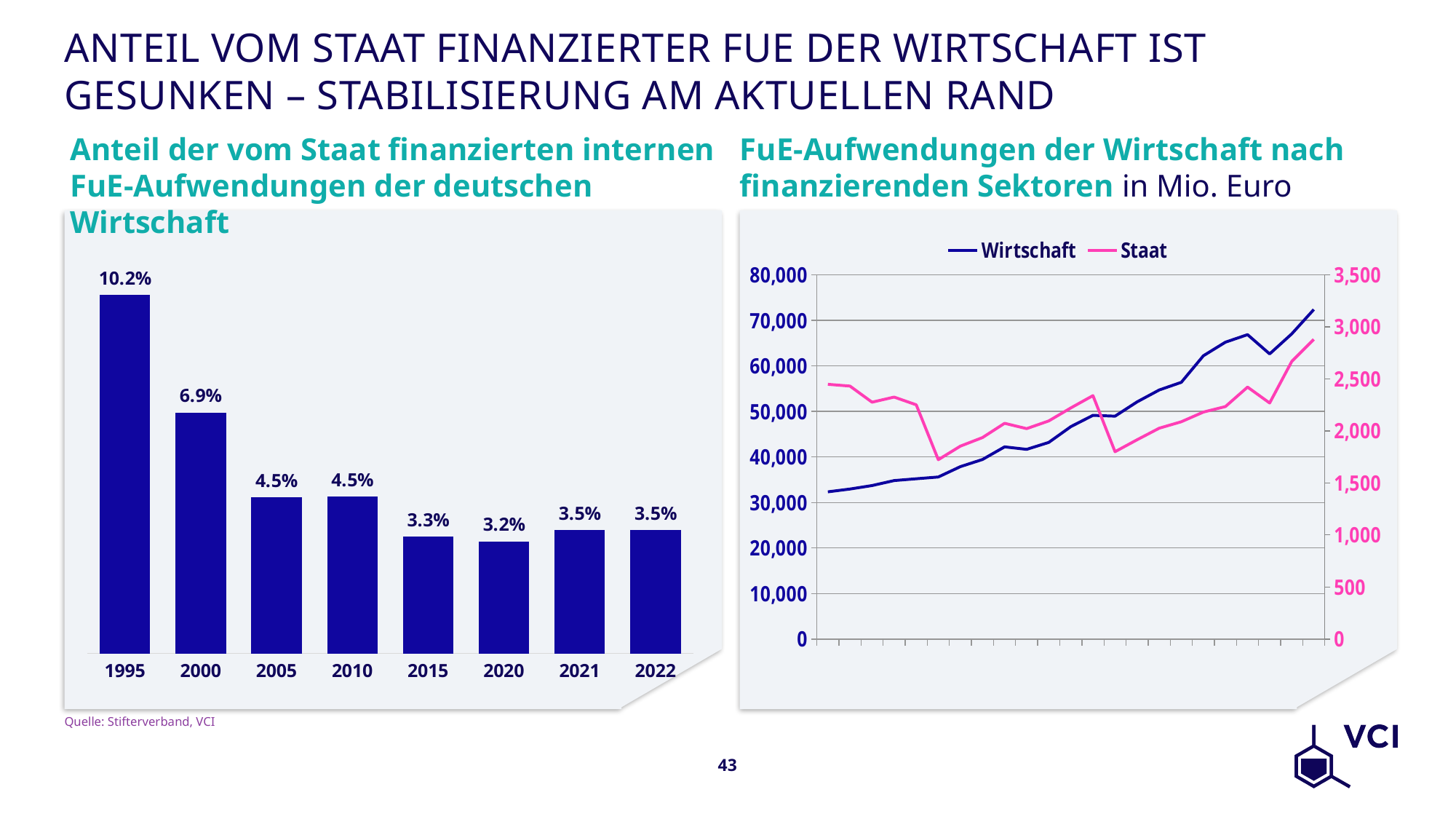
How many series does the legend of the right chart list? 2 In the left bar chart, what is the difference between the values for 1995 and 2000? 3.3% In the left bar chart, which is larger, the value for 2015 or the value for 2021? 2021 In the right chart, does the Wirtschaft line generally rise or fall from left to right? rise In the left bar chart, which year has the highest value? 1995 How many bars are shown in the left bar chart? 8 In the left bar chart, which year has the lowest value? 2020 What kind of chart is the right chart? line chart In the left bar chart, what is the value for 1995? 10.2% In the left bar chart, what is the value for 2020? 3.2% In the left bar chart, what is the value for 2022? 3.5% What kind of chart is the left chart? bar chart